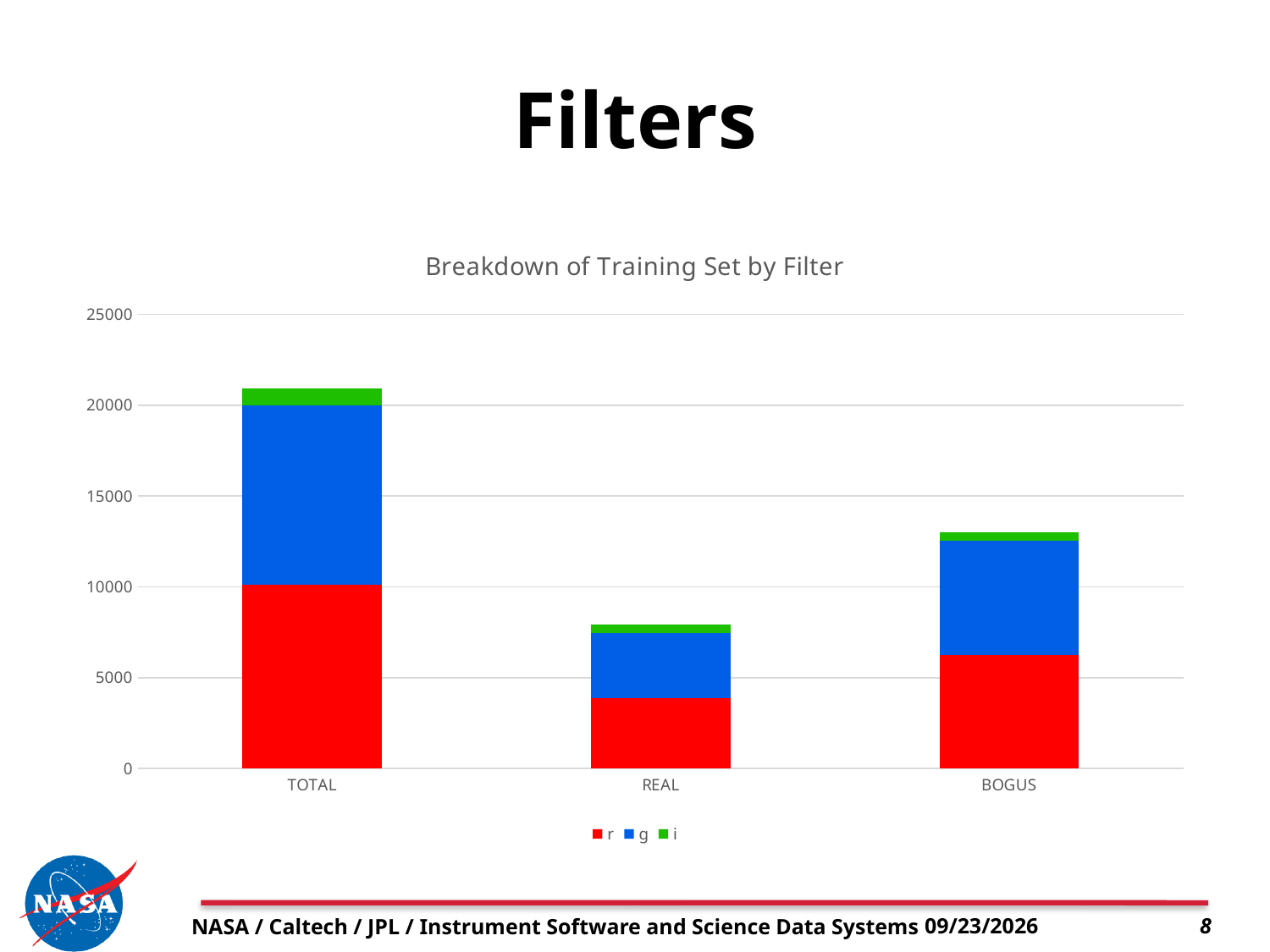
Which category has the shortest stacked bar? REAL Which stacked bar is taller, REAL or BOGUS? BOGUS Which colour represents the i series in the legend? green How many series does the legend list? 3 Is the total height of the REAL bar greater or less than 10000? less What type of chart is shown on the slide? stacked bar chart Is the total height of the TOTAL bar greater or less than 20000? greater How many categories are shown on the x axis? 3 Is the r segment of the REAL bar greater or less than 5000? less Which category has the tallest stacked bar? TOTAL What is the title of the chart? Breakdown of Training Set by Filter